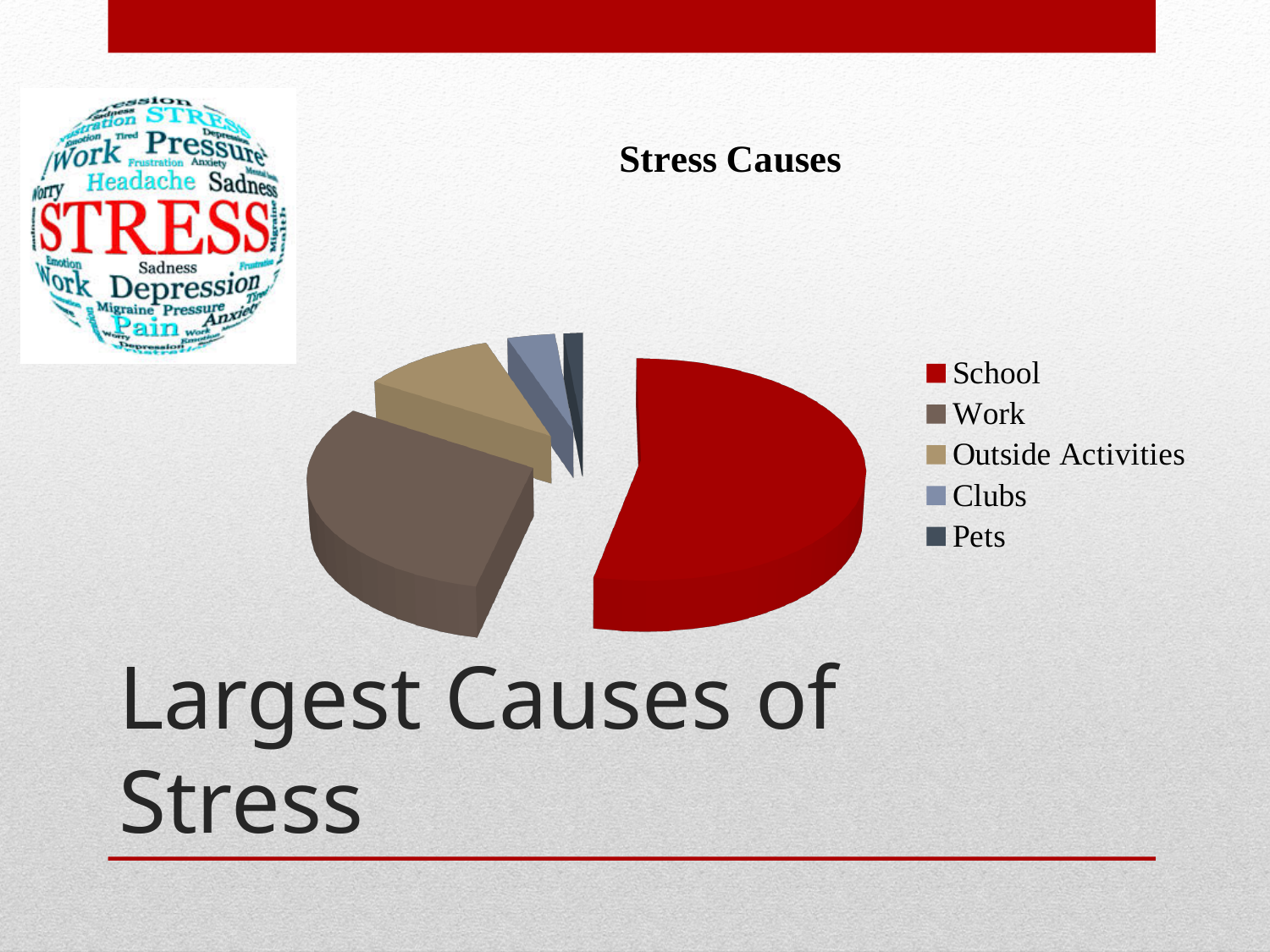
Which category has the smallest slice of the pie? Pets Which slice is larger, School or Work? School What kind of chart is shown on the slide? pie chart Which slice is larger, Work or Outside Activities? Work What is the title of the chart? Stress Causes What colour is the School slice in the pie chart? red Which slice is larger, Clubs or Pets? Clubs How many categories does the pie chart show? 5 Which category has the largest slice of the pie? School Which category has the second-largest slice of the pie? Work